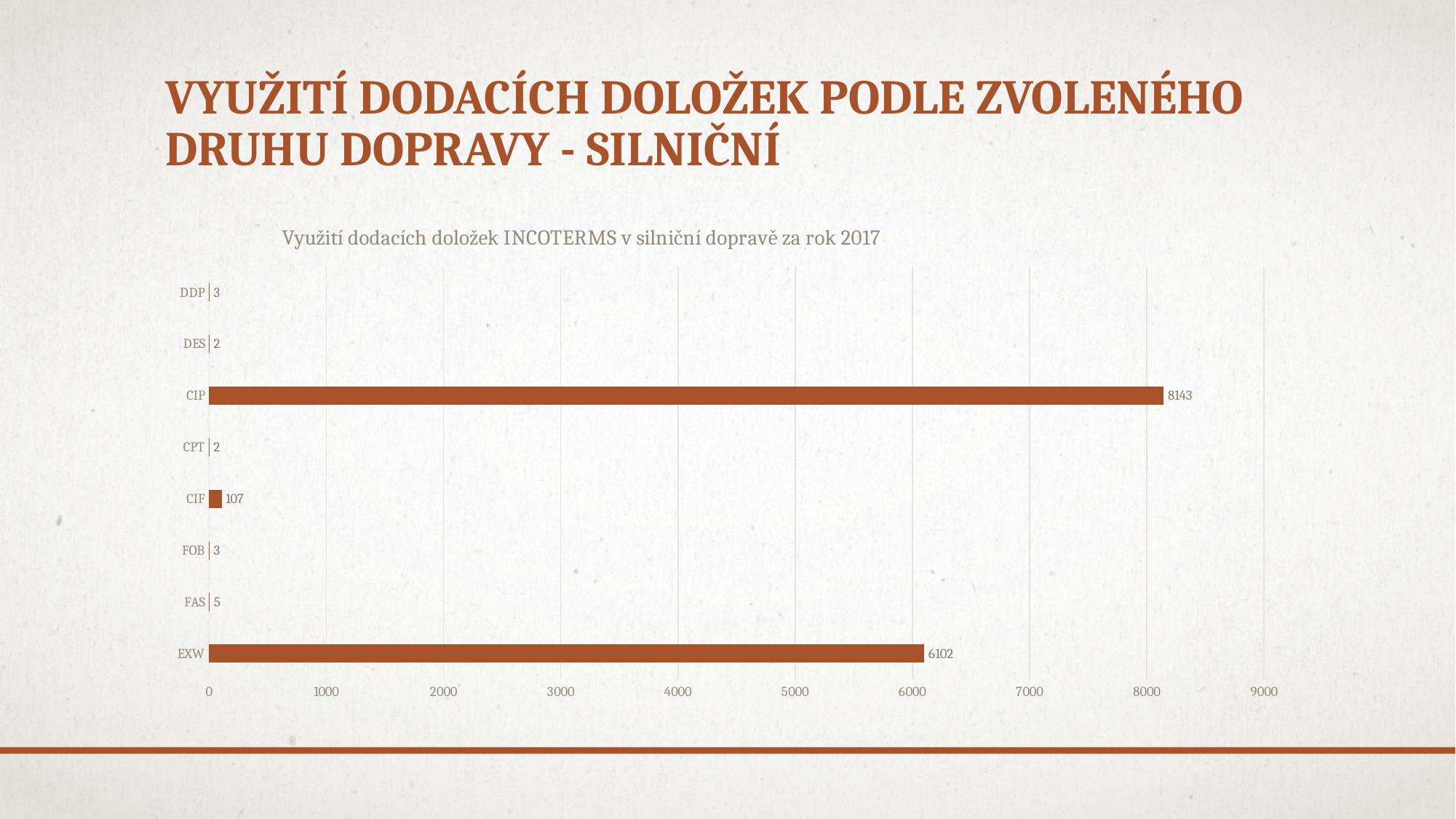
What is the value for CIF? 107 What is the title of the chart? Využití dodacích doložek INCOTERMS v silniční dopravě za rok 2017 What is the value for CIP? 8143 Which category has the highest value? CIP Is the value for EXW greater or less than 5000? greater How many categories are shown on the chart? 8 What is the difference between the values for DDP and DES? 1 Which is larger, the value for CIF or the value for FOB? CIF What kind of chart is shown on the slide? bar chart What is the difference between the values for CIP and EXW? 2041 What is the value for EXW? 6102 What is the value for FAS? 5